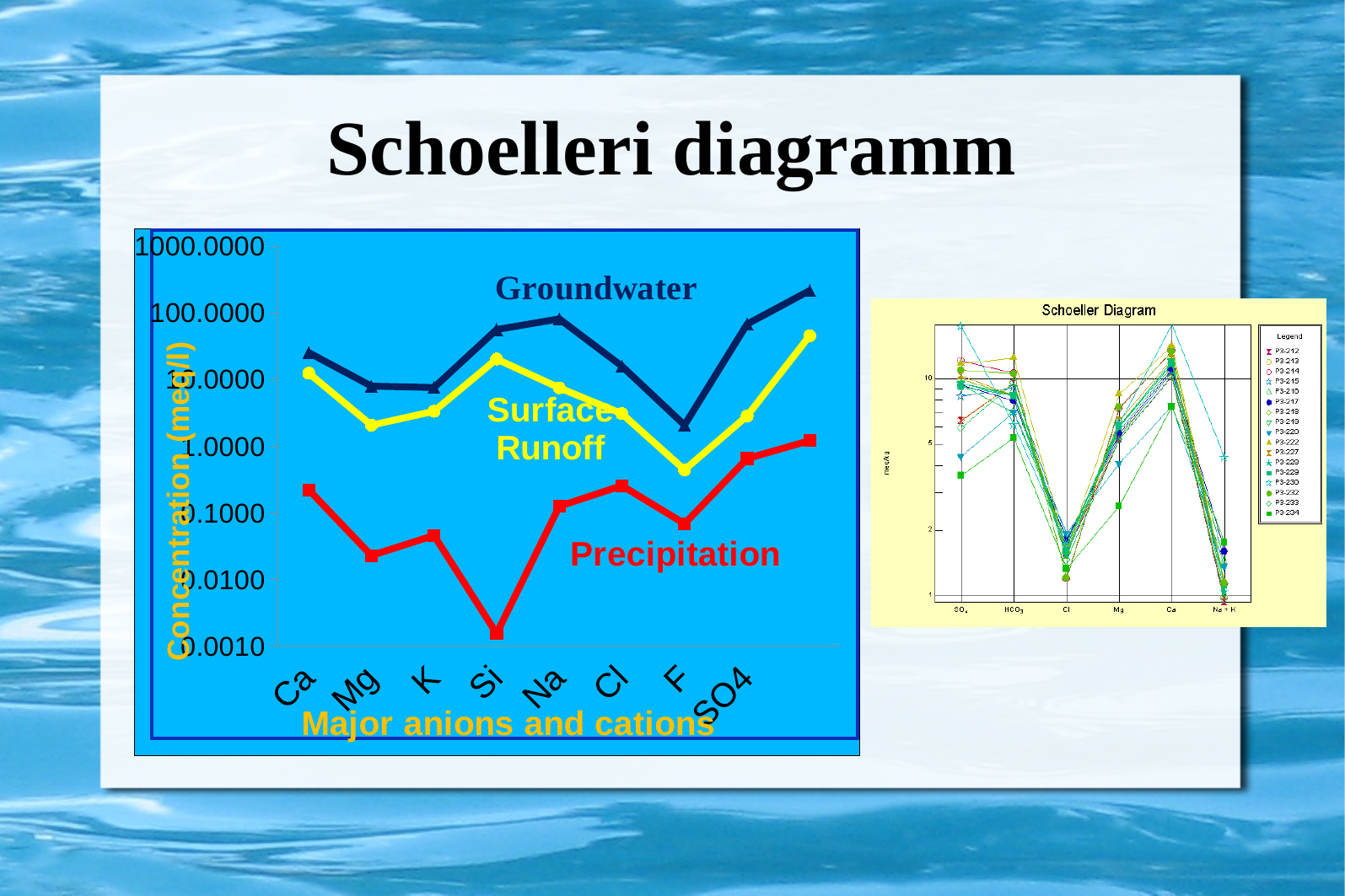
On the left chart, is the Precipitation value for Si greater or less than 0.0100? less On the left chart, how many ions are shown along the x axis? 8 On the left chart, what kind of chart is it? line chart On the left chart, which is larger at Na: the Groundwater value or the Precipitation value? Groundwater On the left chart, which series has the highest concentrations across all ions? Groundwater On the right chart titled Schoeller Diagram, how many ion categories are shown along the x axis? 6 On the left chart, what is the label of the y axis? Concentration (meq/l) On the left chart, how many series are plotted? 3 On the left chart, is the Surface Runoff value for F greater or less than 1.0000? less On the left chart, at which ion does the Precipitation series reach its lowest value? Si On the left chart, is the Groundwater value for SO4 greater or less than 100.0000? less